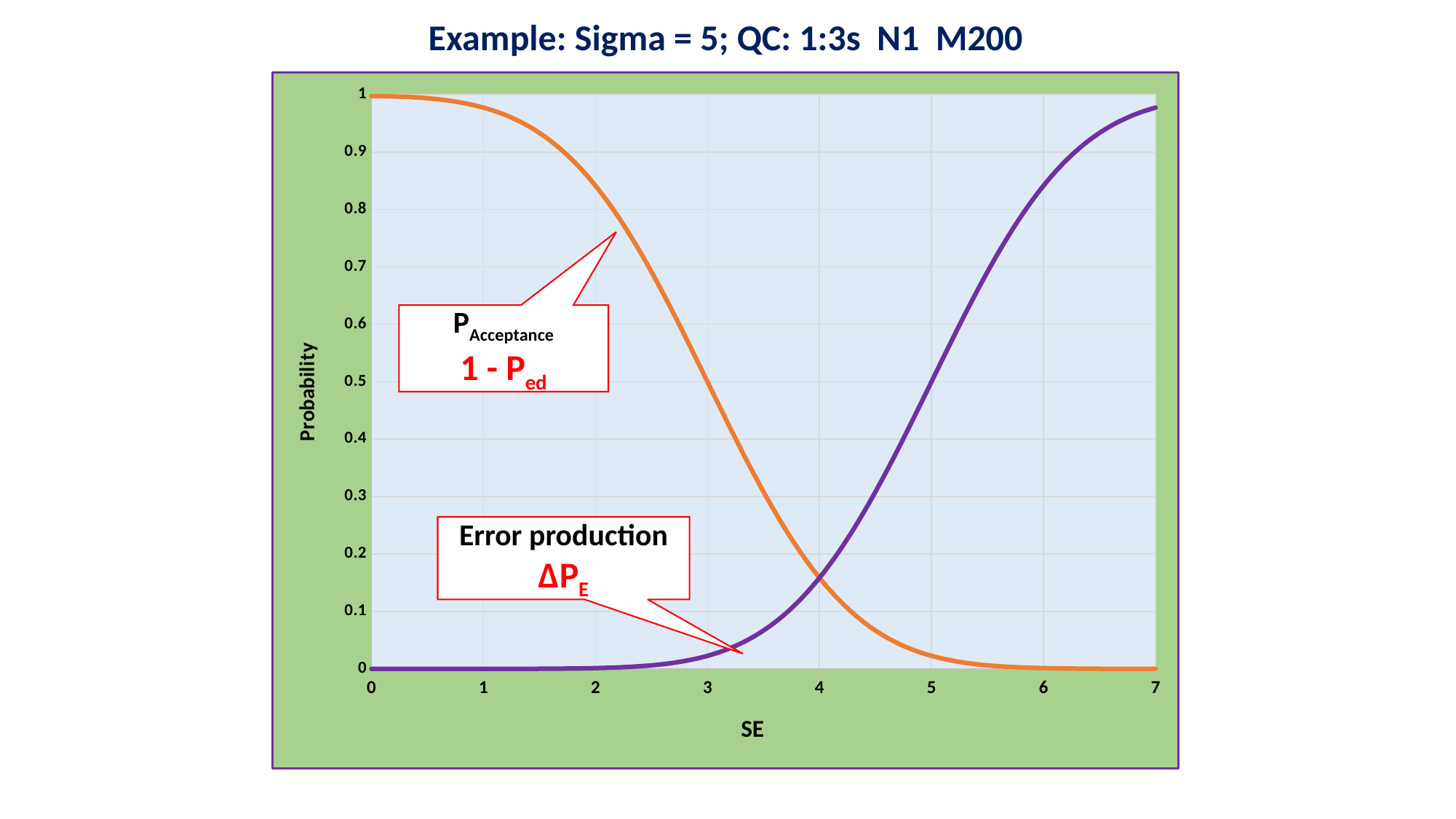
What kind of chart is shown on the slide? line chart Does the purple Error production (ΔPE) curve rise or fall as SE increases? rise How many curves are plotted on the chart? 2 Is the value of the purple Error production curve at SE = 6 greater or less than 0.8? greater What is the label of the x axis? SE Is the value of the orange P Acceptance curve at SE = 1 greater or less than 0.9? greater What is the title of the chart? Example: Sigma = 5; QC: 1:3s N1 M200 Is the value of the purple Error production curve at SE = 3 greater or less than 0.1? less At SE = 6, which curve is higher, the orange P Acceptance curve or the purple Error production curve? purple Error production curve Does the orange P Acceptance (1 - Ped) curve rise or fall as SE increases? fall At SE = 2, which curve is higher, the orange P Acceptance curve or the purple Error production curve? orange P Acceptance curve